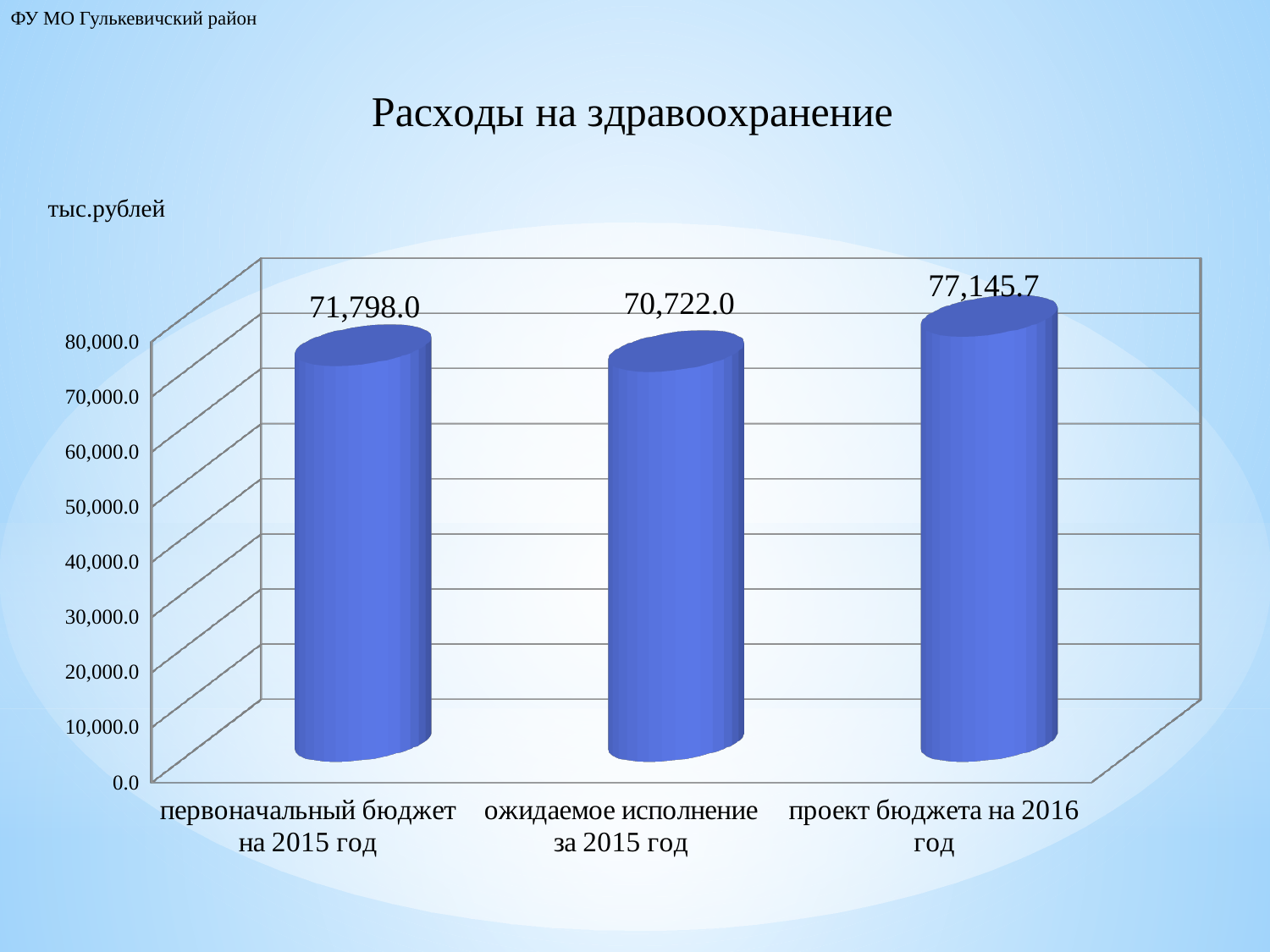
What is the value for 'проект бюджета на 2016 год'? 77,145.7 What is the title of the chart? Расходы на здравоохранение What is the difference between 'проект бюджета на 2016 год' and 'первоначальный бюджет на 2015 год'? 5,347.7 Which category has the highest value? проект бюджета на 2016 год Is the value for 'проект бюджета на 2016 год' greater or less than 70,000.0? greater Which category has the lowest value? ожидаемое исполнение за 2015 год What is the value for 'первоначальный бюджет на 2015 год'? 71,798.0 How many categories are shown in the chart? 3 Which is larger: 'первоначальный бюджет на 2015 год' or 'ожидаемое исполнение за 2015 год'? первоначальный бюджет на 2015 год What is the difference between 'первоначальный бюджет на 2015 год' and 'ожидаемое исполнение за 2015 год'? 1,076.0 What is the value for 'ожидаемое исполнение за 2015 год'? 70,722.0 What kind of chart is shown on the slide? bar chart